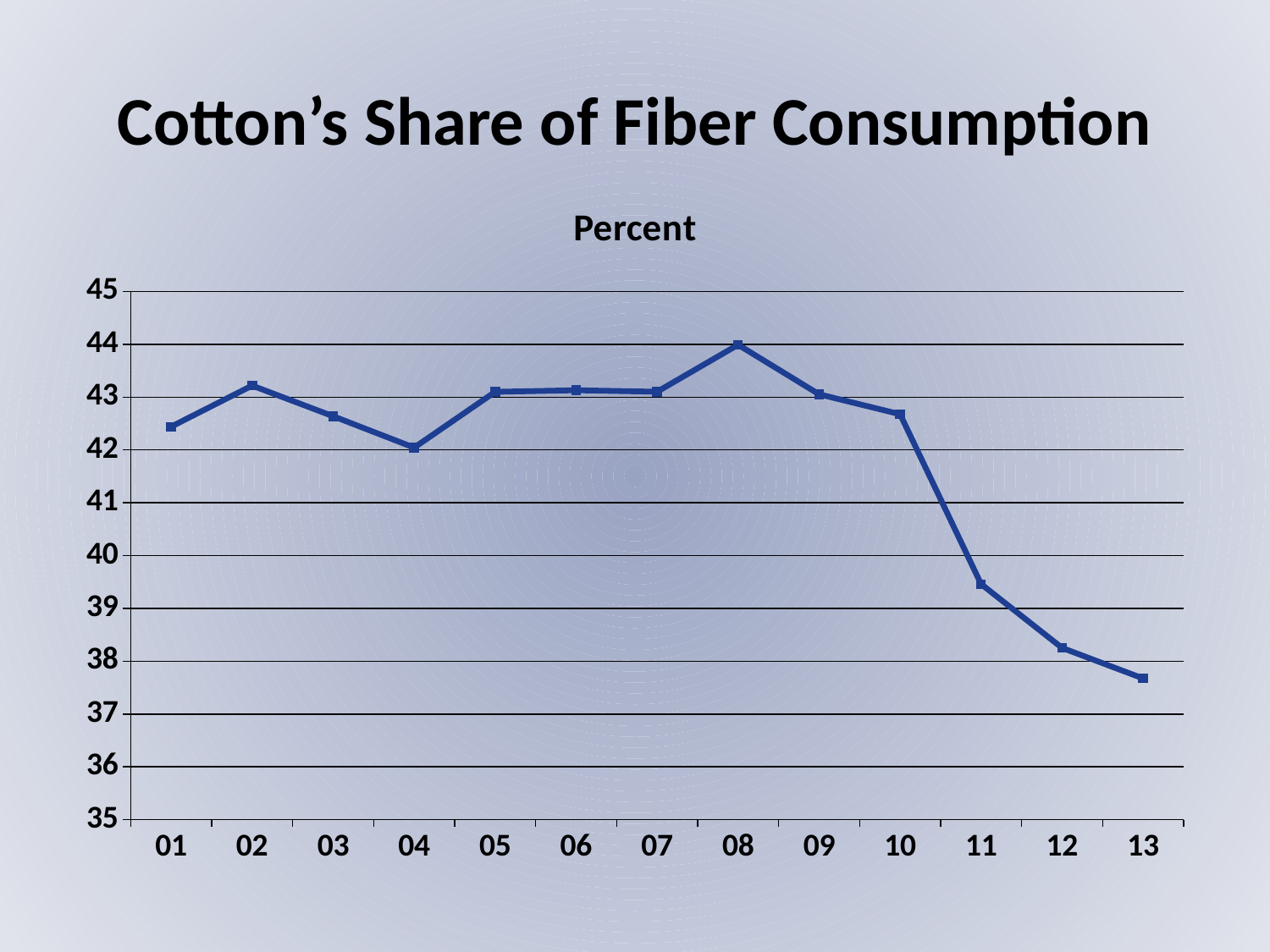
Is the value for 10 greater or less than 42? greater Is the value for 08 greater or less than 43? greater Do the values rise or fall from 10 to 13? fall How many years are plotted along the x axis? 13 What is the title of the chart on the slide? Cotton's Share of Fiber Consumption Which year has the larger value, 02 or 04? 02 What kind of chart is shown on the slide? line chart What unit label appears above the chart's plot area? Percent In which year is cotton's share of fiber consumption highest? 08 In which year is cotton's share of fiber consumption lowest? 13 Is the value for 13 greater or less than 38? less